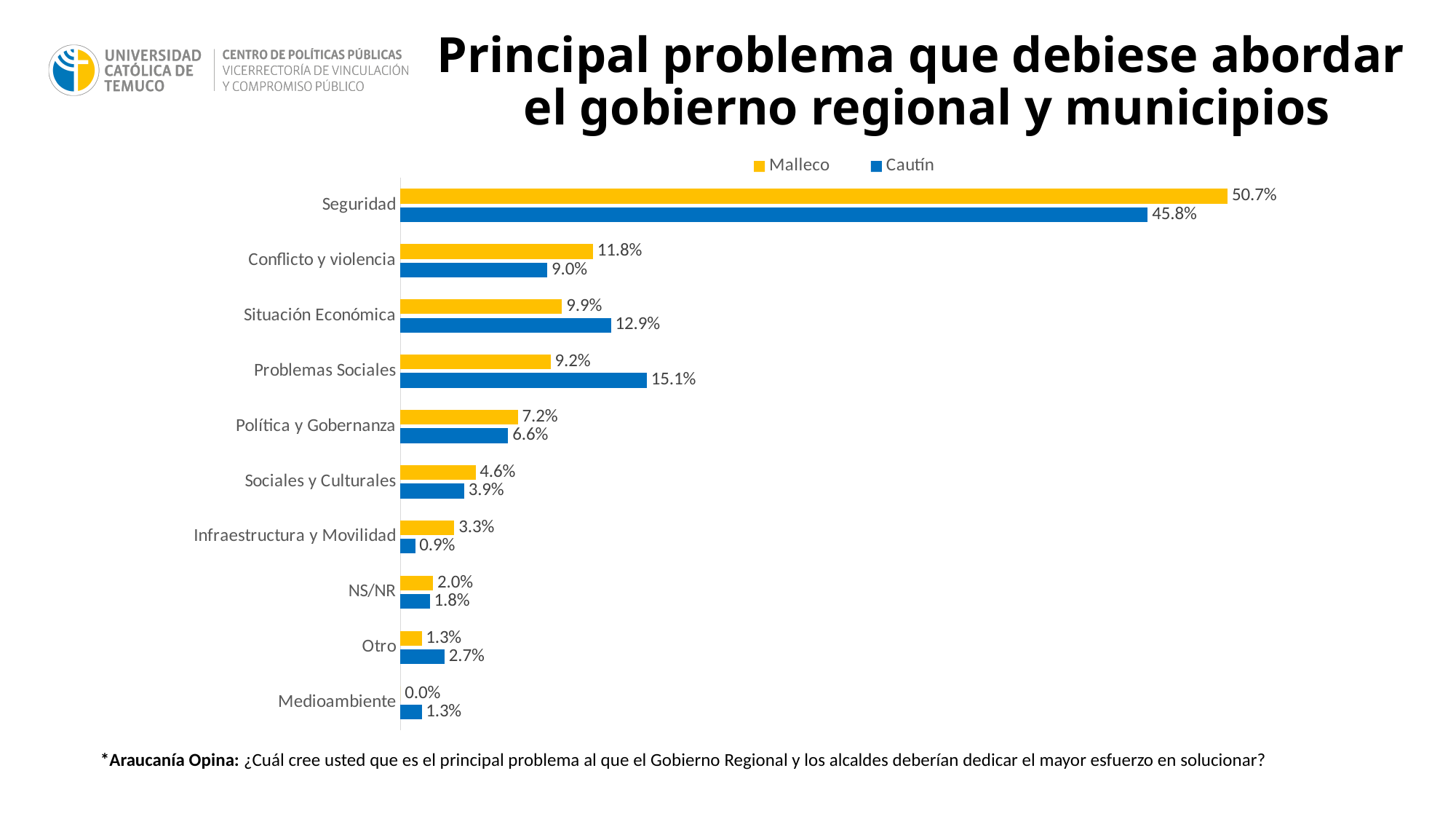
Which category has the highest Cautín value? Seguridad Which colour represents the Malleco series? Yellow What is the Cautín value for Infraestructura y Movilidad? 0.9% What is the Cautín value for Problemas Sociales? 15.1% Which is larger for Situación Económica, the Malleco value or the Cautín value? Cautín What kind of chart is shown on the slide? Bar chart How many categories are shown on the chart? 10 What is the difference between the Malleco and Cautín values for Seguridad? 4.9% What is the Malleco value for Medioambiente? 0.0% Which category has the lowest Malleco value? Medioambiente What is the Malleco value for Seguridad? 50.7% How many series does the legend list? 2